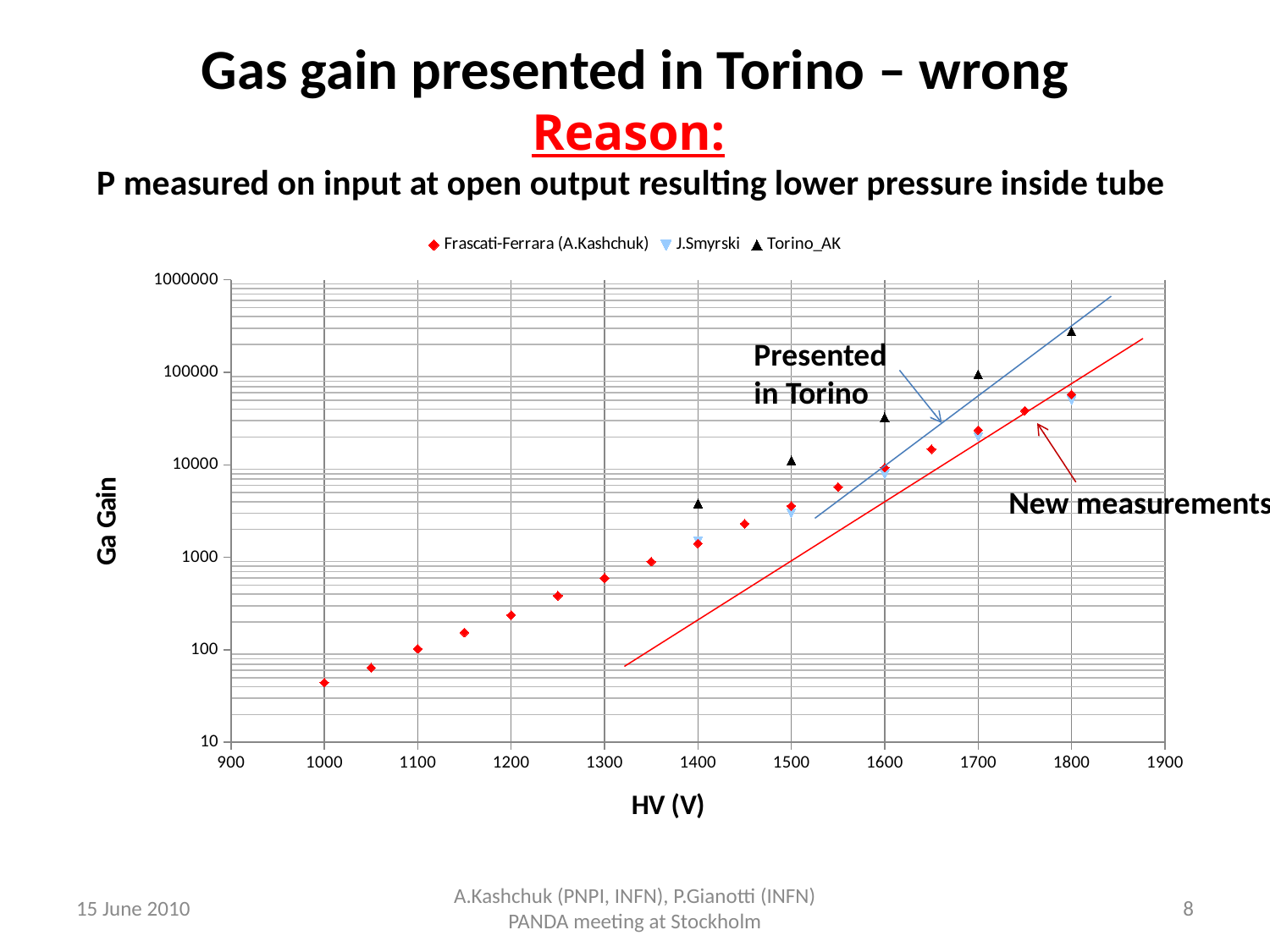
How many series does the chart legend list? 3 Which series is plotted with black triangle markers? Torino_AK Is the Frascati-Ferrara (A.Kashchuk) value at 1300 V greater or less than 1000? less Do the Frascati-Ferrara (A.Kashchuk) values rise or fall as HV increases? rise Is the Frascati-Ferrara (A.Kashchuk) value at 1000 V greater or less than 100? less What is the title of the x axis of the chart? HV (V) What kind of chart is shown on the slide? scatter chart Which series reaches the highest gas gain on the chart? Torino_AK At 1700 V, which series has the larger gas gain, Torino_AK or Frascati-Ferrara (A.Kashchuk)? Torino_AK How many data points are plotted for the Frascati-Ferrara (A.Kashchuk) series? 17 Is the Torino_AK value at 1800 V greater or less than 100000? greater How many data points are plotted for the Torino_AK series? 5